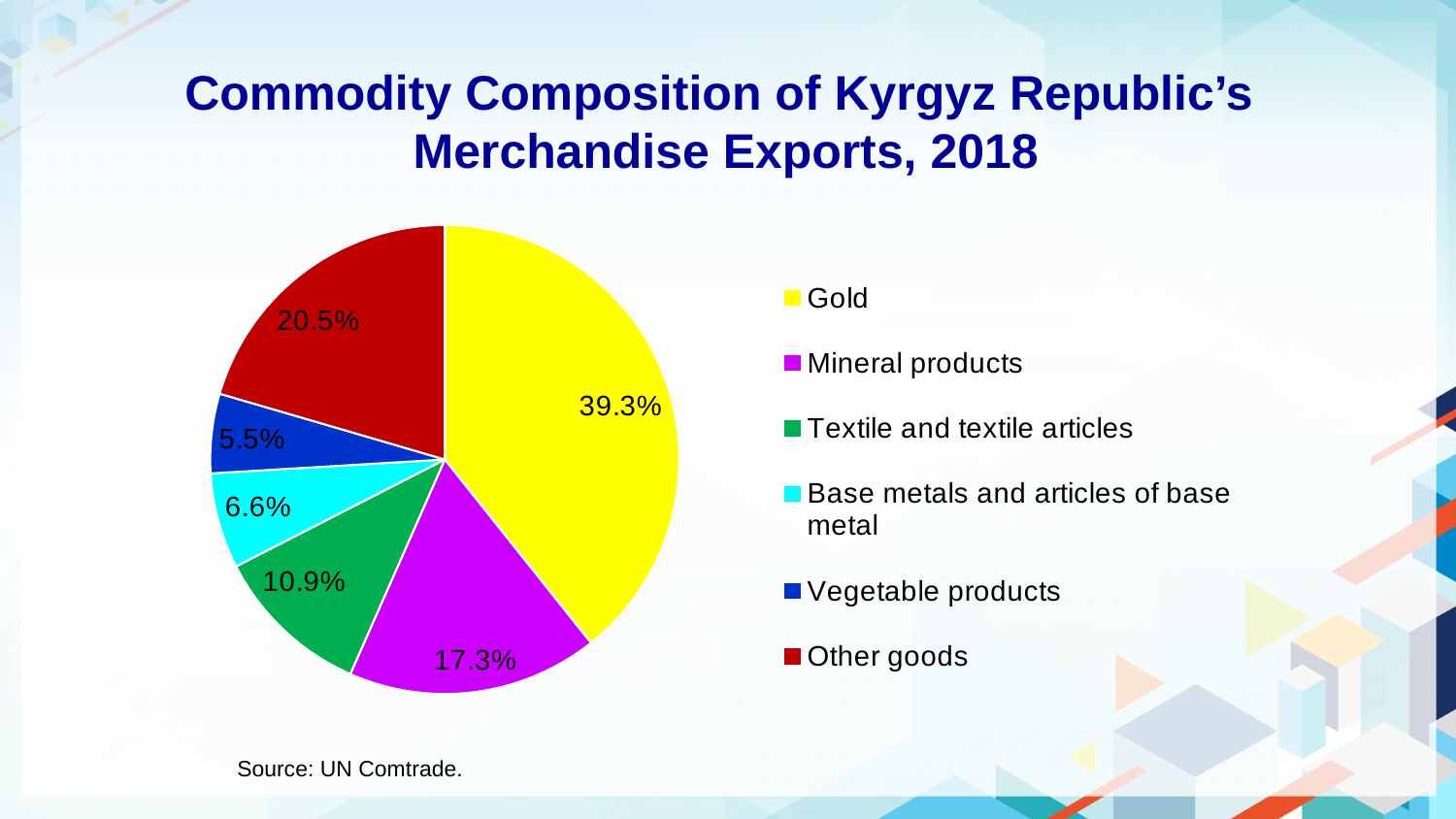
Which commodity category has the smallest share of exports? Vegetable products What share of exports was other goods? 20.5% What type of chart is shown on the slide? Pie chart What share of Kyrgyz Republic's merchandise exports in 2018 was gold? 39.3% Which commodity category has the largest share of exports? Gold What colour represents mineral products in the pie chart? Magenta What share of exports was textile and textile articles? 10.9% What share of exports was vegetable products? 5.5% What share of exports was mineral products? 17.3% Which has a larger share of exports, base metals and articles of base metal or textile and textile articles? Textile and textile articles What is the difference in percentage points between the gold share and the other goods share? 18.8 How many commodity categories are shown in the pie chart? 6